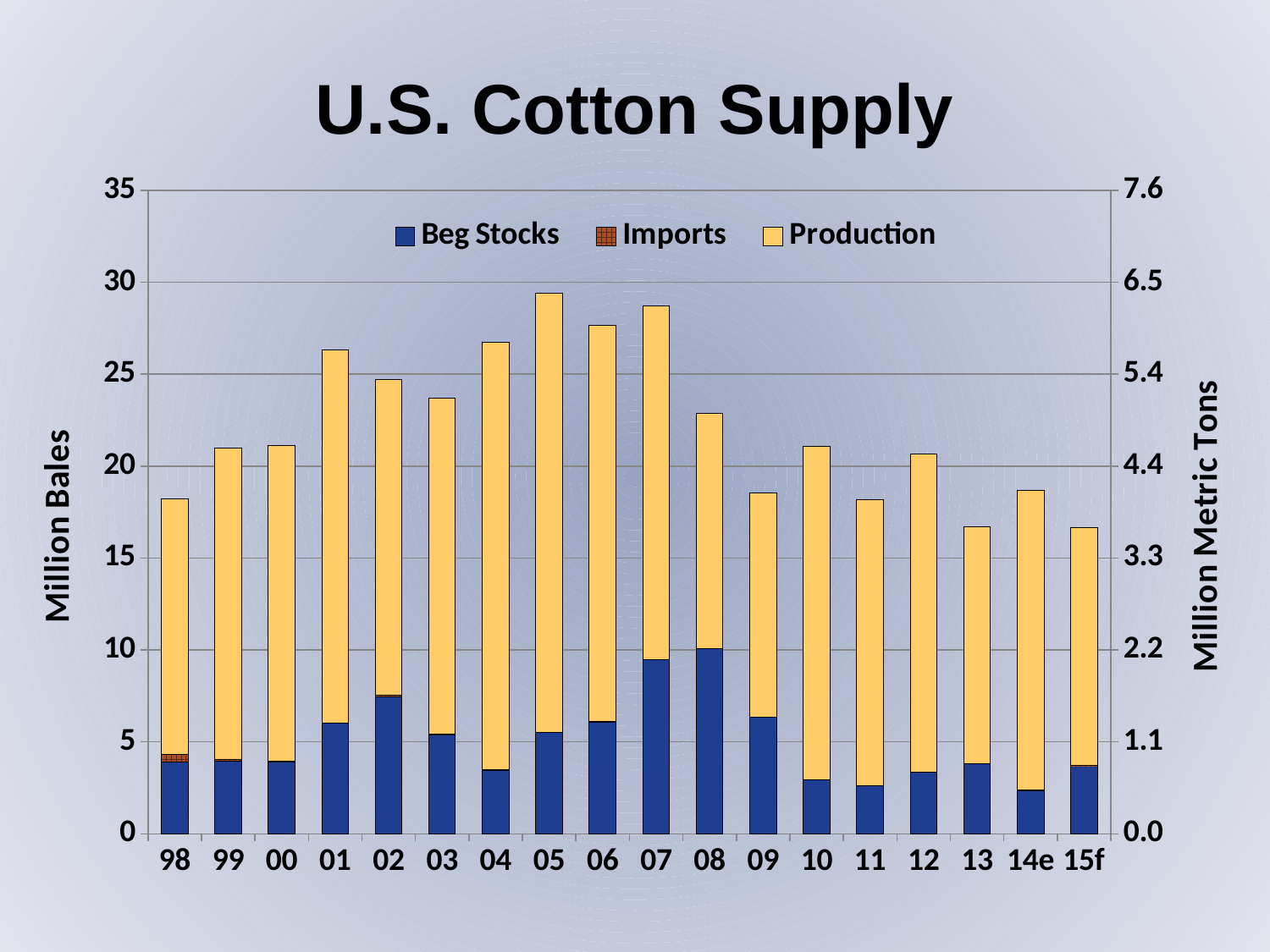
Is the total supply for 98 greater or less than 20 million bales? less Is the total supply for 05 greater or less than 25 million bales? greater Is the Beg Stocks value for 07 greater or less than 5 million bales? greater How many series does the legend list? 3 What kind of chart is shown on the slide? Stacked bar chart What is the label of the right-hand vertical axis? Million Metric Tons Which year has the highest total U.S. cotton supply? 05 Does the total supply rise or fall from 98 to 01? rise Which year has the largest Beg Stocks segment? 08 How many years (categories) are shown on the x axis? 18 Which year has the larger total supply, 05 or 06? 05